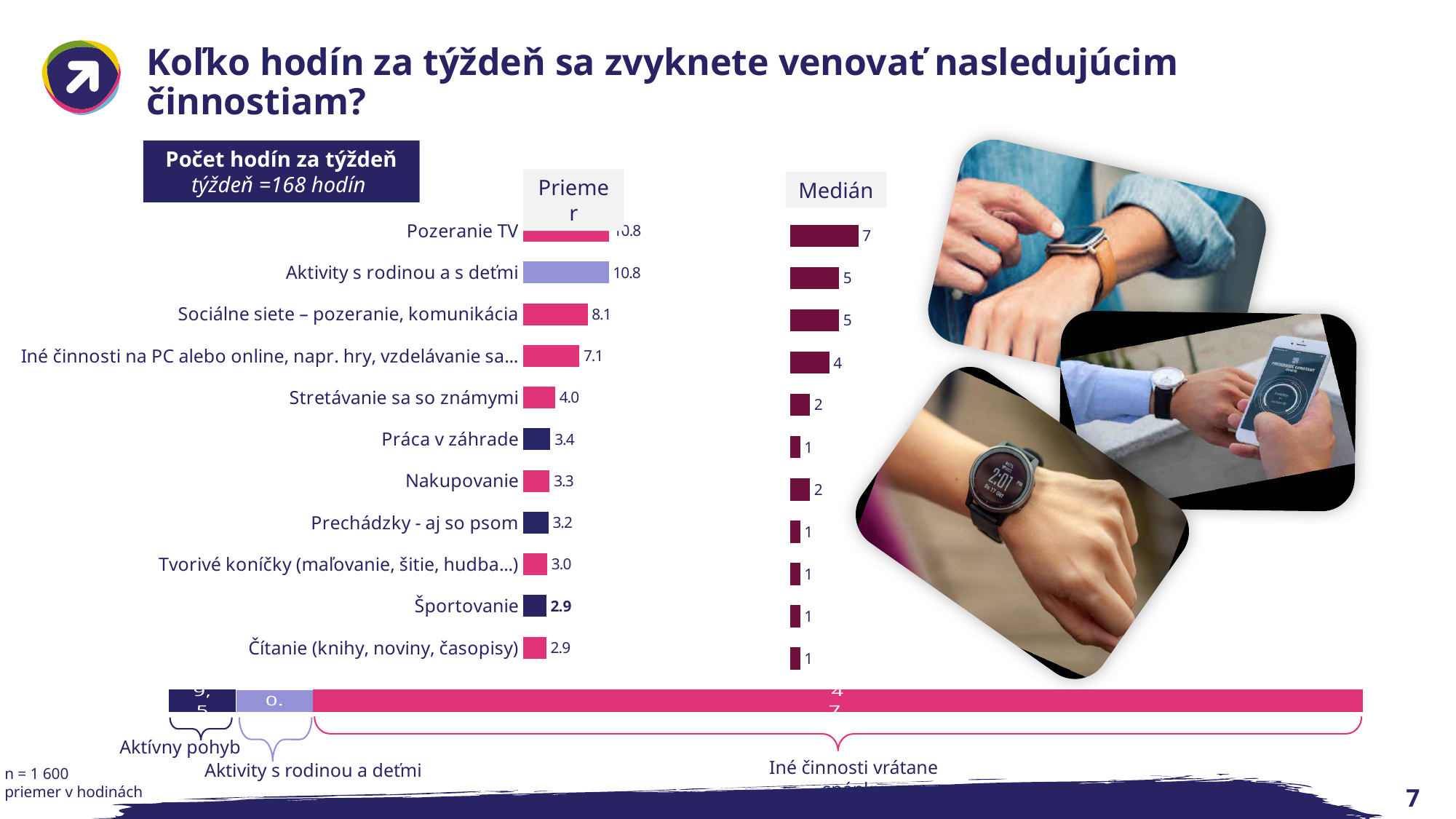
In the Priemer chart, what is the value for Čítanie (knihy, noviny, časopisy)? 2.9 In the Priemer chart, which is larger: Práca v záhrade or Nakupovanie? Práca v záhrade In the Medián chart, what is the difference between Pozeranie TV and Aktivity s rodinou a s deťmi? 2 What kind of chart is the Medián chart? Bar chart In the Medián chart, which category has the highest value? Pozeranie TV In the Medián chart, what is the value for Pozeranie TV? 7 In the Priemer chart, do the values increase or decrease going from the top category to the bottom category? Decrease In the Priemer chart, what is the difference between Pozeranie TV and Športovanie? 7.9 In the Priemer chart, what is the value for Stretávanie sa so známymi? 4.0 How many categories are shown in the Priemer chart? 11 In the Priemer chart, what is the value for Sociálne siete – pozeranie, komunikácia? 8.1 In the Medián chart, what is the value for Iné činnosti na PC alebo online, napr. hry, vzdelávanie sa…? 4